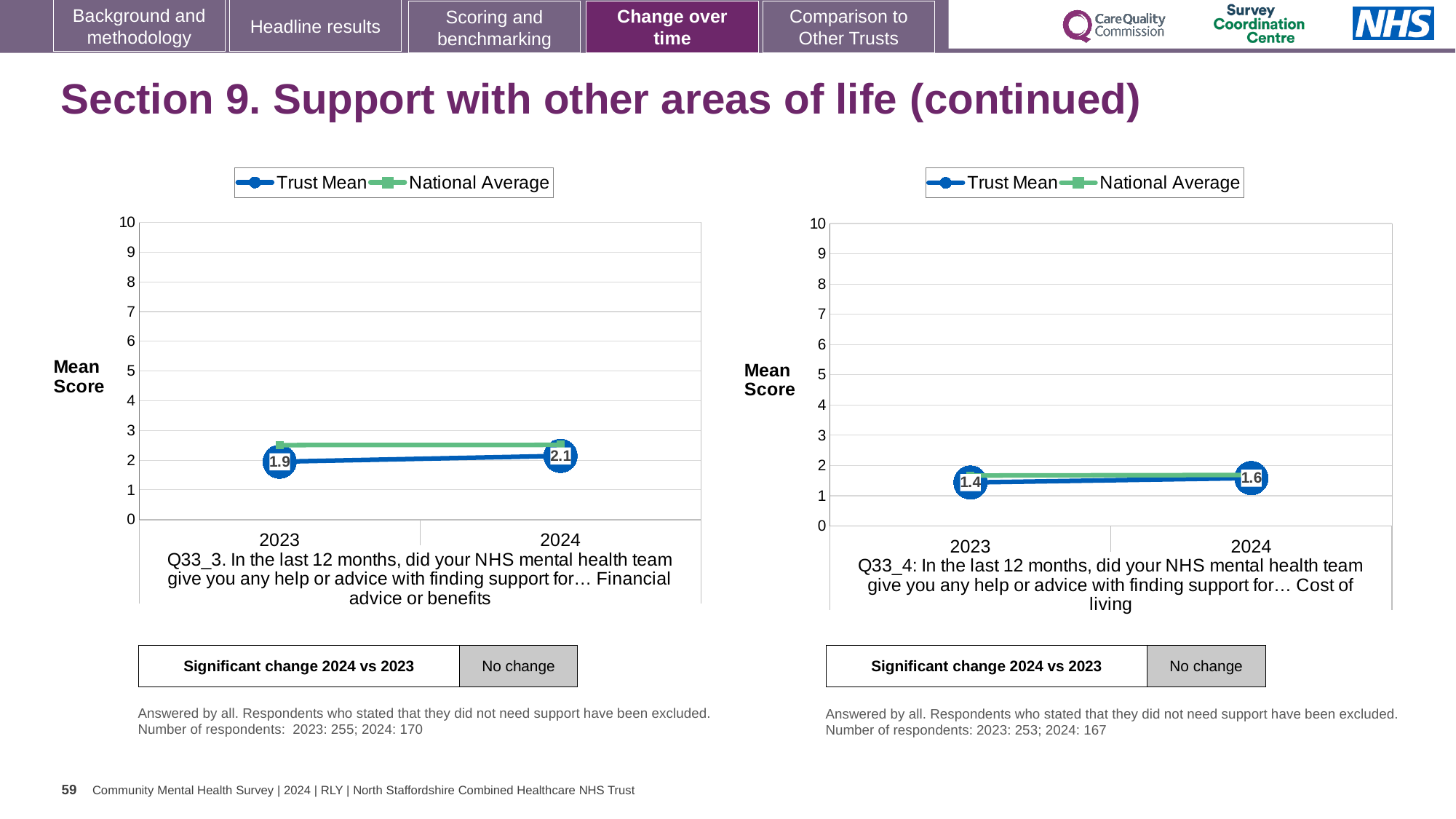
In the left chart (Q33_3, Financial advice or benefits), what is the Trust Mean for 2023? 1.9 In the right chart (Q33_4), does the Trust Mean rise or fall from 2023 to 2024? rise In the left chart (Q33_3), is the National Average for 2023 greater or less than 3? less In the left chart (Q33_3), which is larger for 2023: the Trust Mean or the National Average? National Average In the left chart (Q33_3), by how much did the Trust Mean change from 2023 to 2024? 0.2 How many years are plotted on the x axis of the left chart (Q33_3)? 2 In the right chart (Q33_4, Cost of living), what is the Trust Mean for 2024? 1.6 What kind of chart is the left chart (Q33_3)? line chart How many series does the legend of the right chart (Q33_4) list? 2 In the right chart (Q33_4), what is the difference between the Trust Mean for 2024 and 2023? 0.2 In the right chart (Q33_4, Cost of living), what is the Trust Mean for 2023? 1.4 In the left chart (Q33_3, Financial advice or benefits), what is the Trust Mean for 2024? 2.1